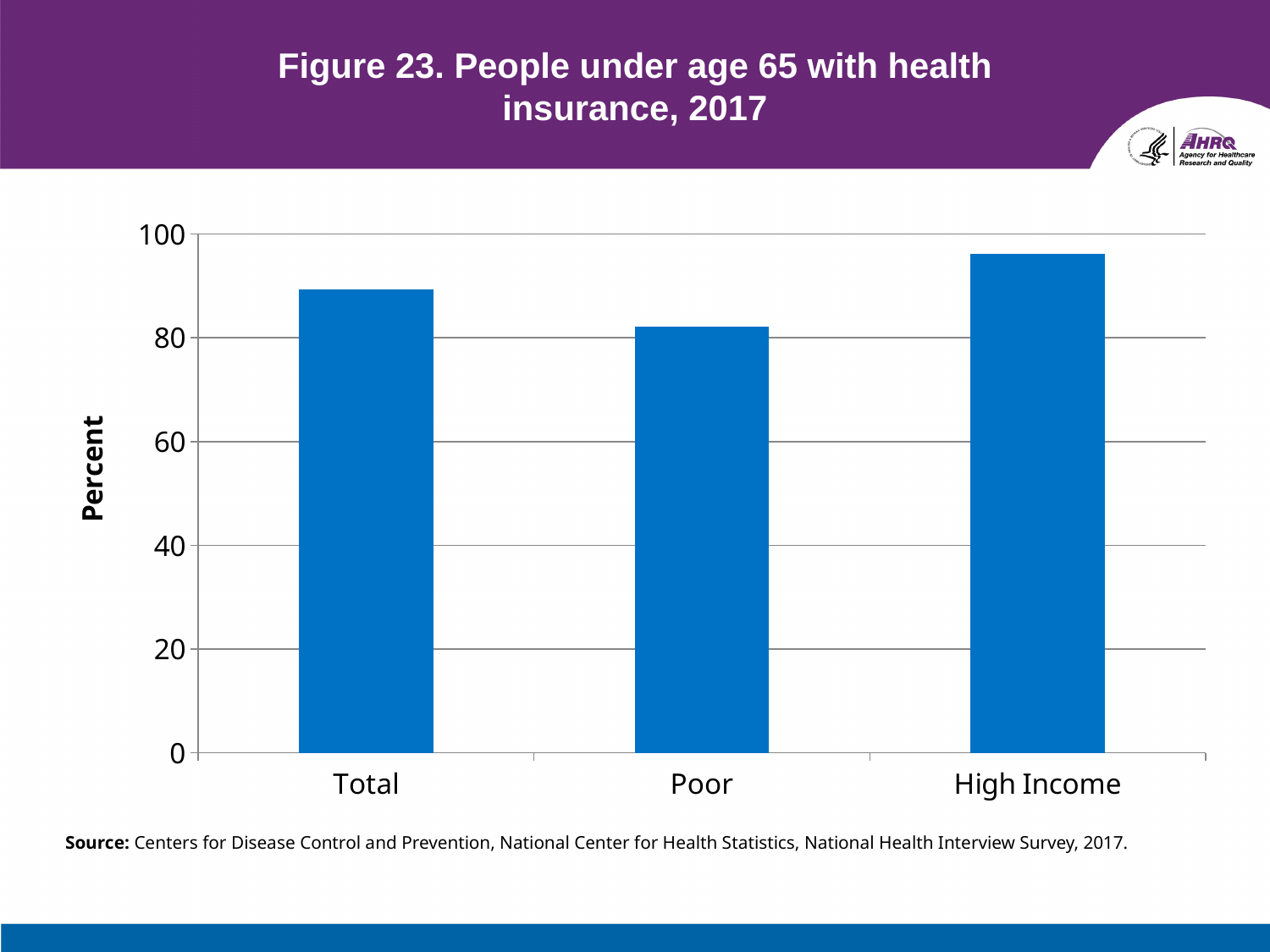
Which is larger, the value for Total or the value for Poor? Total Is the value for Poor greater or less than 60? greater Which category has the lowest percentage of people under age 65 with health insurance? Poor How many categories are shown on the x axis? 3 What is the label on the y axis of the chart? Percent Is the value for High Income greater or less than 80? greater Is the value for High Income greater or less than 100? less Which category has the highest percentage of people under age 65 with health insurance? High Income What kind of chart is shown on the slide? bar chart What is the title of the chart on the slide? Figure 23. People under age 65 with health insurance, 2017 Which is larger, the value for High Income or the value for Total? High Income